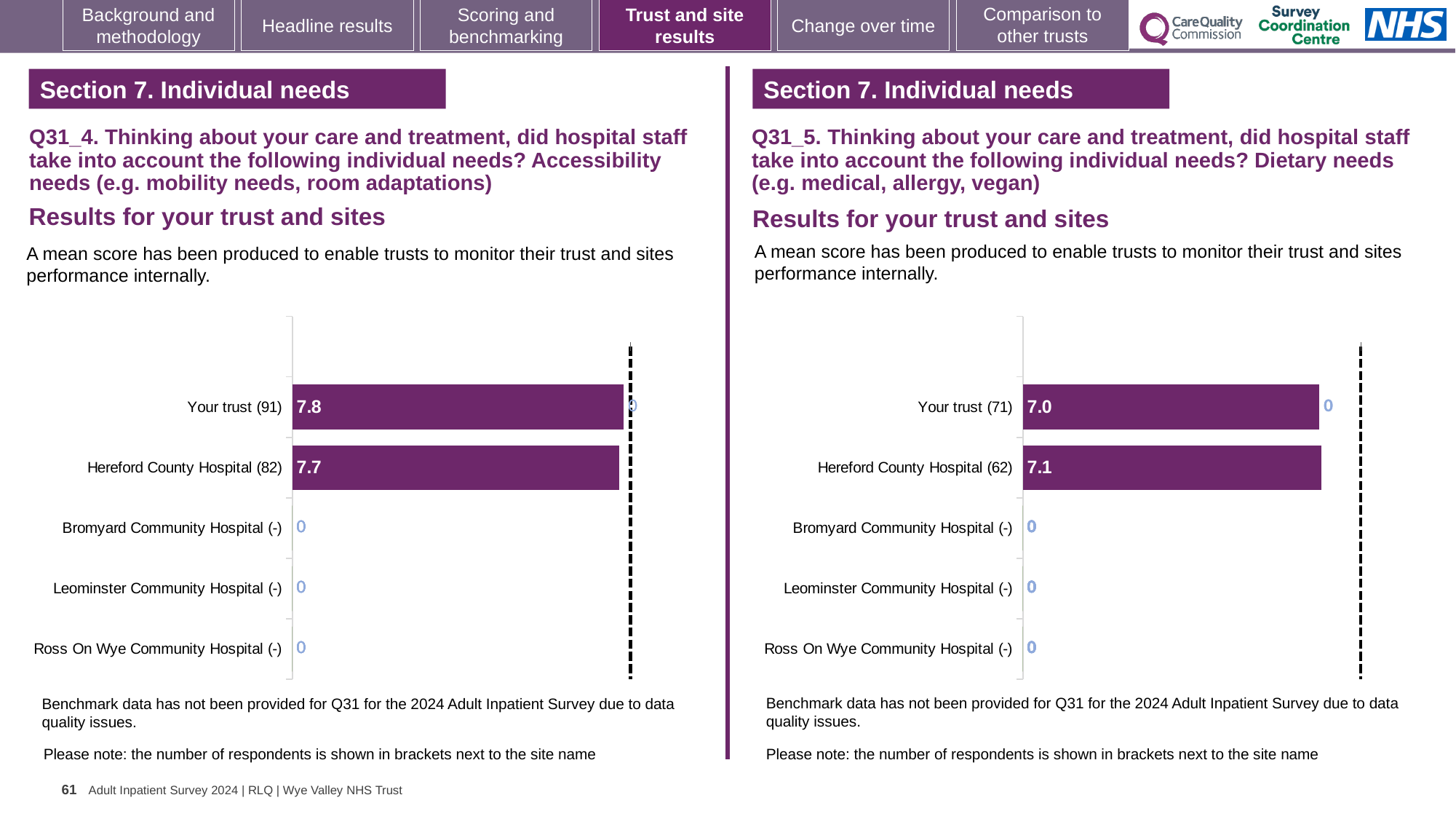
On the Q31_4 (accessibility needs) chart, what is the mean score for Your trust? 7.8 On the Q31_5 (dietary needs) chart, what is the mean score for Your trust? 7.0 How many categories are listed on the Q31_5 (dietary needs) chart? 5 On the Q31_5 (dietary needs) chart, how many respondents are shown for Hereford County Hospital? 62 On the Q31_4 (accessibility needs) chart, which has the higher score, Your trust or Hereford County Hospital? Your trust On the Q31_4 (accessibility needs) chart, what is the mean score for Hereford County Hospital? 7.7 On the Q31_4 (accessibility needs) chart, how many respondents are shown for Your trust? 91 On the Q31_5 (dietary needs) chart, what is the mean score for Hereford County Hospital? 7.1 On the Q31_5 (dietary needs) chart, what is the difference between the scores for Hereford County Hospital and Your trust? 0.1 What kind of chart is used for the Q31_4 (accessibility needs) results? Bar chart On the Q31_4 (accessibility needs) chart, what is the difference between the scores for Your trust and Hereford County Hospital? 0.1 On the Q31_5 (dietary needs) chart, which has the higher score, Your trust or Hereford County Hospital? Hereford County Hospital